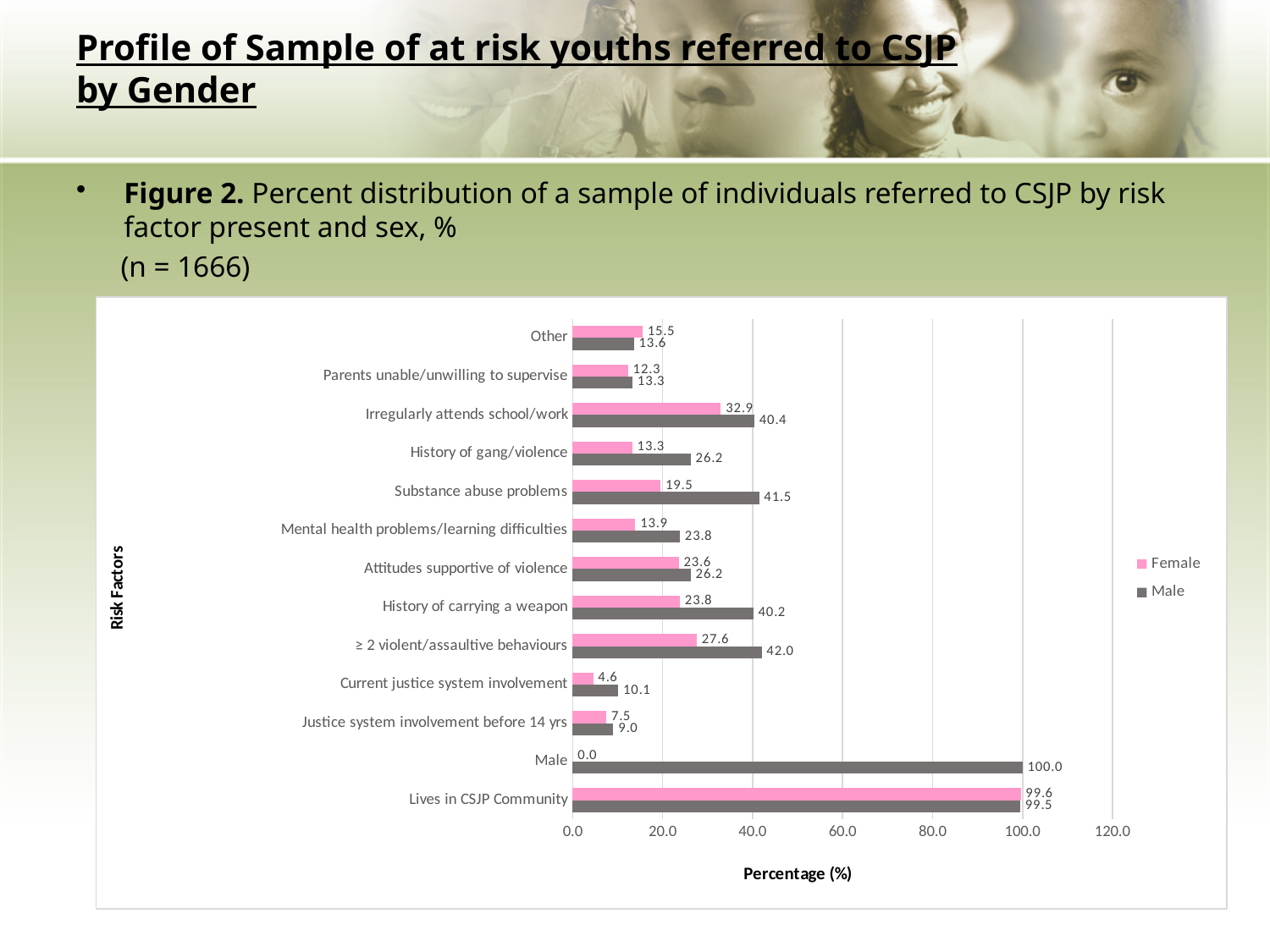
What kind of chart is shown on the slide? Bar chart What is the Male value for Substance abuse problems? 41.5 What is the Female value for Irregularly attends school/work? 32.9 Excluding the Male and Lives in CSJP Community categories, which risk factor has the highest Male value? ≥ 2 violent/assaultive behaviours What is the Female value for Current justice system involvement? 4.6 How many risk factor categories are shown on the chart? 13 What is the label of the horizontal axis? Percentage (%) Which risk factor has the lowest Female value? Male What is the Male value for History of carrying a weapon? 40.2 What is the difference between the Male and Female values for Substance abuse problems? 22.0 Which is larger for Other: the Female value or the Male value? Female How many series does the legend list? 2